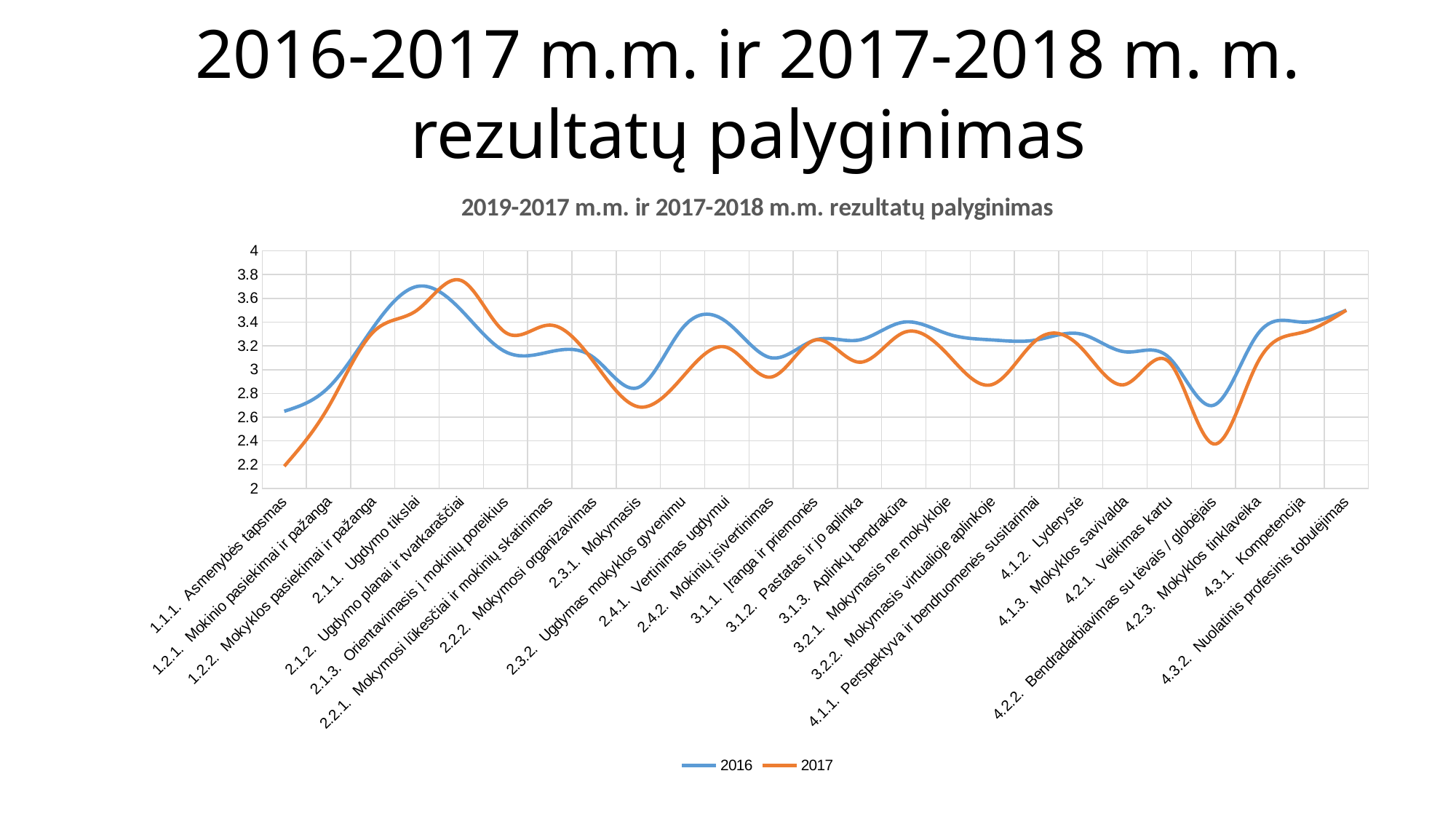
Is the 2016 value for 1.1.1. Asmenybės tapsmas greater or less than 2.4? greater Which category has the highest value in the 2017 series? 2.1.2. Ugdymo planai ir tvarkaraščiai Is the 2017 value for 1.1.1. Asmenybės tapsmas greater or less than 2.4? less Which colour is used for the 2017 series? orange How many categories are plotted along the x axis? 25 Which category has the lowest value in the 2017 series? 1.1.1. Asmenybės tapsmas Is the 2017 value for 2.1.2. Ugdymo planai ir tvarkaraščiai greater or less than 3.6? greater For 1.1.1. Asmenybės tapsmas, which series has the higher value, 2016 or 2017? 2016 What kind of chart is shown on the slide? line chart How many series does the legend list? 2 For 2.1.2. Ugdymo planai ir tvarkaraščiai, which series has the higher value, 2016 or 2017? 2017